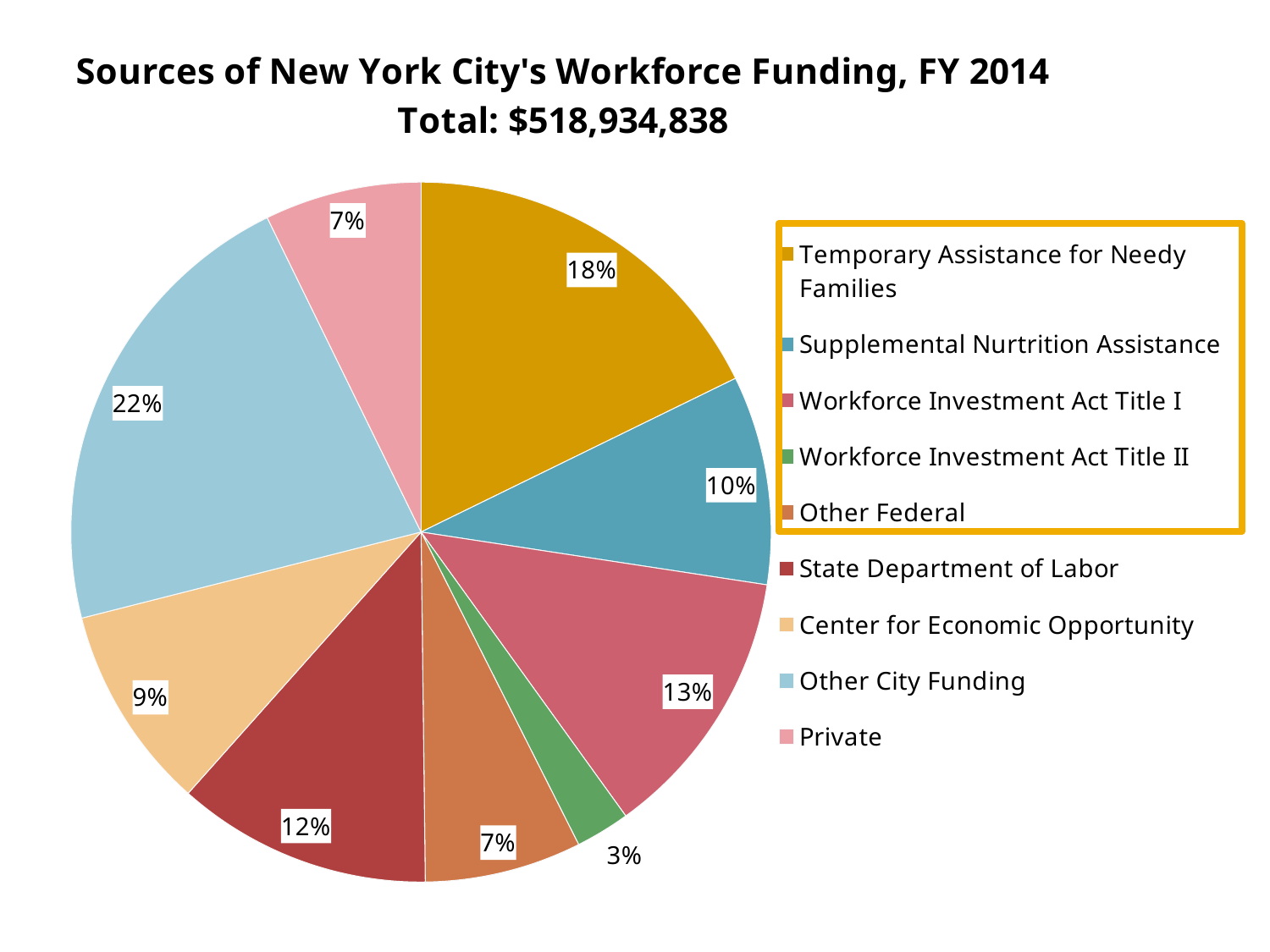
What share of funding comes from the Center for Economic Opportunity? 9% Which funding source has the largest share of the pie? Other City Funding How many legend entries are enclosed in the gold box? 5 What share of funding comes from Other City Funding? 22% Which funding source has the smallest share of the pie? Workforce Investment Act Title II How many percentage points larger is the Other City Funding share than the State Department of Labor share? 10 percentage points How many funding sources are shown in the pie chart? 9 What is the total funding amount stated in the chart title? $518,934,838 What kind of chart is shown on the slide? pie chart Which is larger: the Workforce Investment Act Title I share or the Supplemental Nutrition Assistance share? Workforce Investment Act Title I What percentage of funding comes from Temporary Assistance for Needy Families? 18% What percentage of funding comes from Other Federal sources? 7%